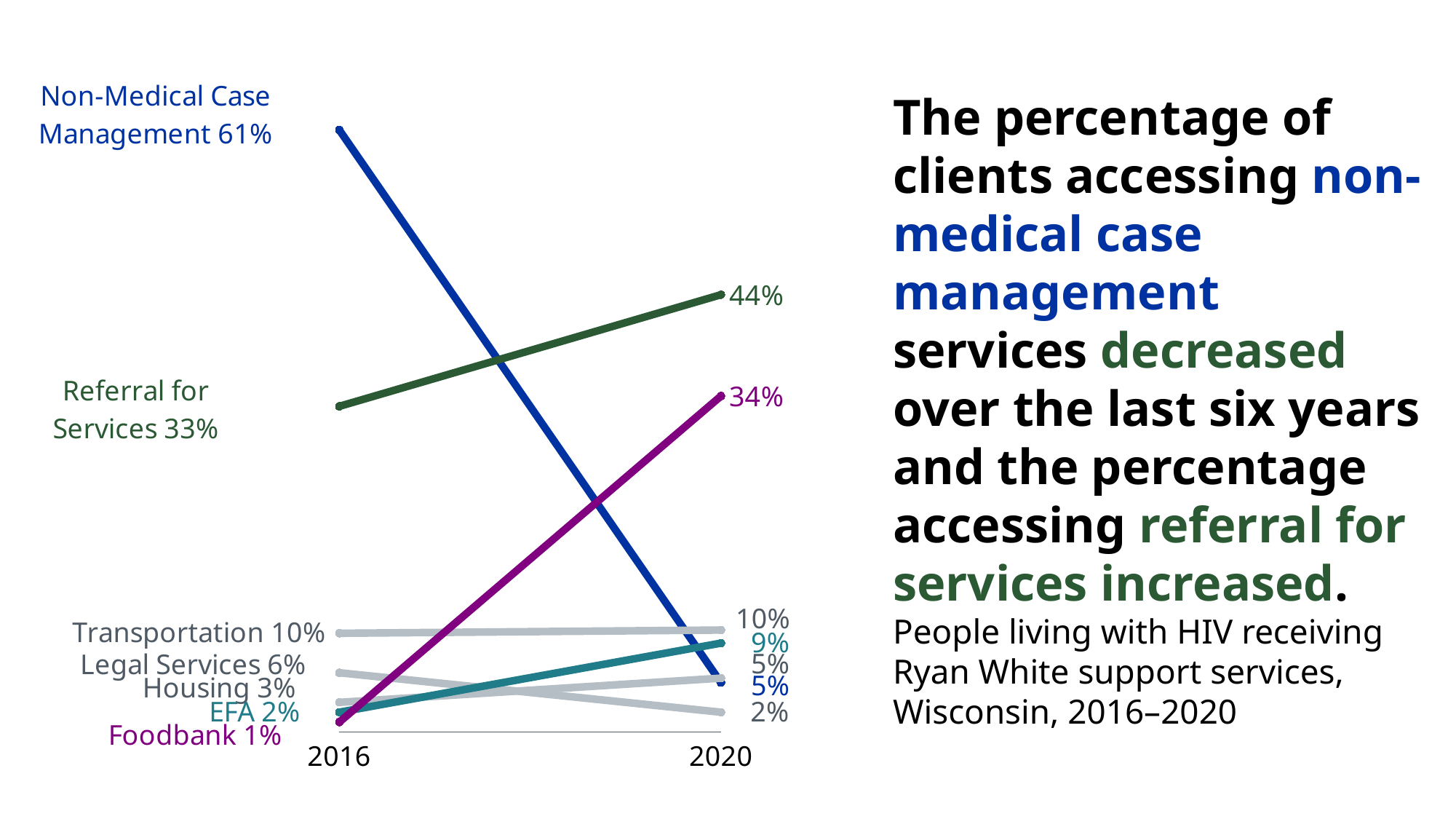
How many services are plotted on the chart? 7 By how many percentage points did Non-Medical Case Management fall from 2016 to 2020? 56 percentage points What percentage of clients accessed Referral for Services in 2020? 44% What percentage of clients accessed Non-Medical Case Management in 2016? 61% What is the 2020 value for EFA? 9% Which service had the highest percentage in 2020? Referral for Services Which service had the highest percentage in 2016? Non-Medical Case Management Which service had the lowest percentage in 2016? Foodbank Does the Non-Medical Case Management line rise or fall from 2016 to 2020? fall By how many percentage points did Referral for Services rise from 2016 to 2020? 11 percentage points What kind of chart is shown on the slide? line chart What is the 2020 value for Foodbank? 34%